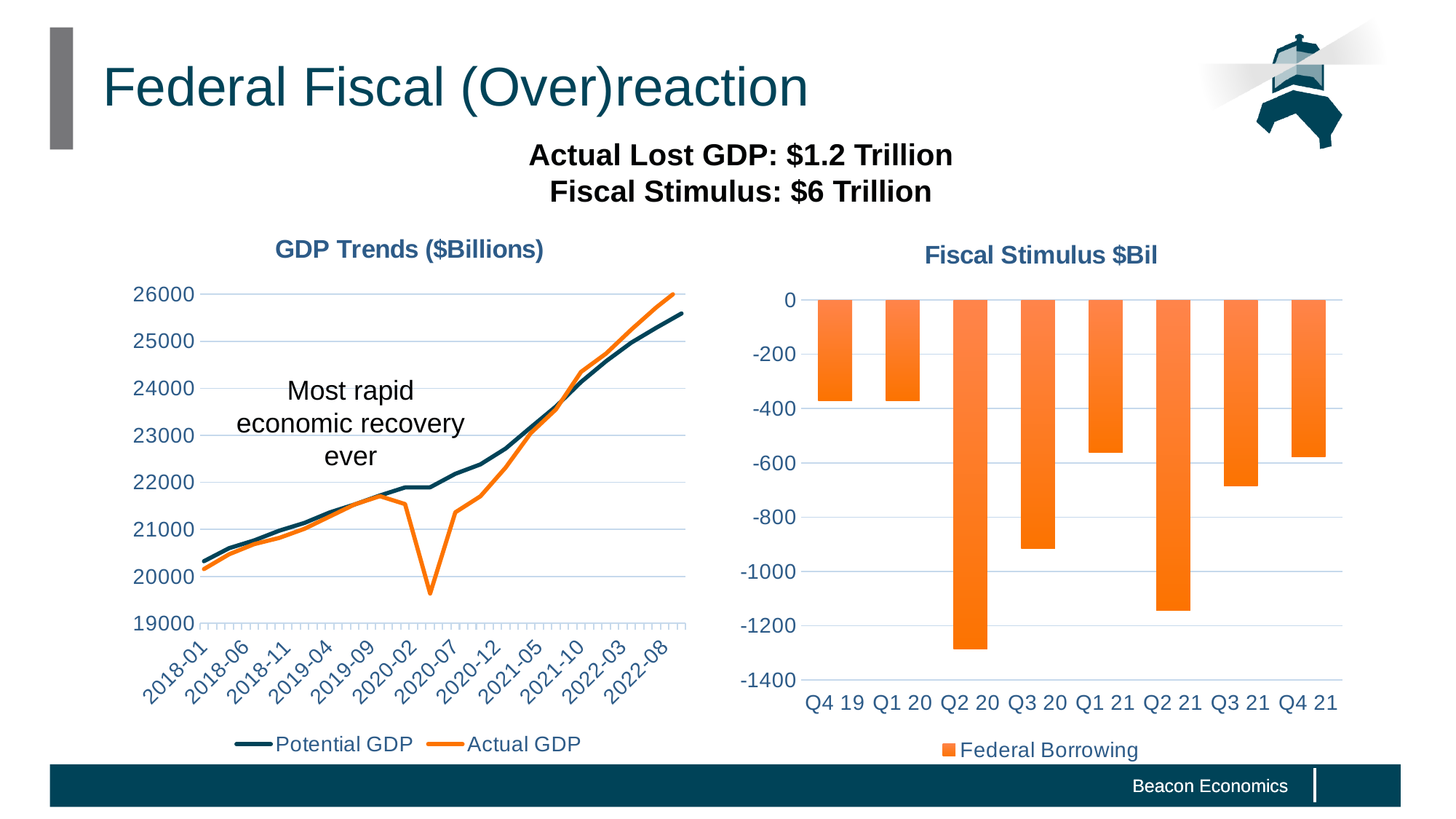
In the "GDP Trends ($Billions)" chart, does the Potential GDP line generally rise or fall from 2018-01 to 2022-08? rise What type of chart is the "Fiscal Stimulus $Bil" chart? bar chart What is the name of the series shown in the legend of the "Fiscal Stimulus $Bil" chart? Federal Borrowing What type of chart is the "GDP Trends ($Billions)" chart? line chart In the "Fiscal Stimulus $Bil" chart, is the value for Q3 20 greater or less than -800? less How many quarters are shown on the x axis of the "Fiscal Stimulus $Bil" chart? 8 In the "GDP Trends ($Billions)" chart, is the lowest point of the Actual GDP line in 2020 greater or less than 20000? less How many series does the legend of the "GDP Trends ($Billions)" chart list? 2 In the "Fiscal Stimulus $Bil" chart, which quarter has the longer bar (more federal borrowing), Q3 20 or Q2 21? Q2 21 In the "Fiscal Stimulus $Bil" chart, is the value for Q2 20 greater or less than -1200? less In the "Fiscal Stimulus $Bil" chart, which quarter has the longest bar (the most negative Federal Borrowing value)? Q2 20